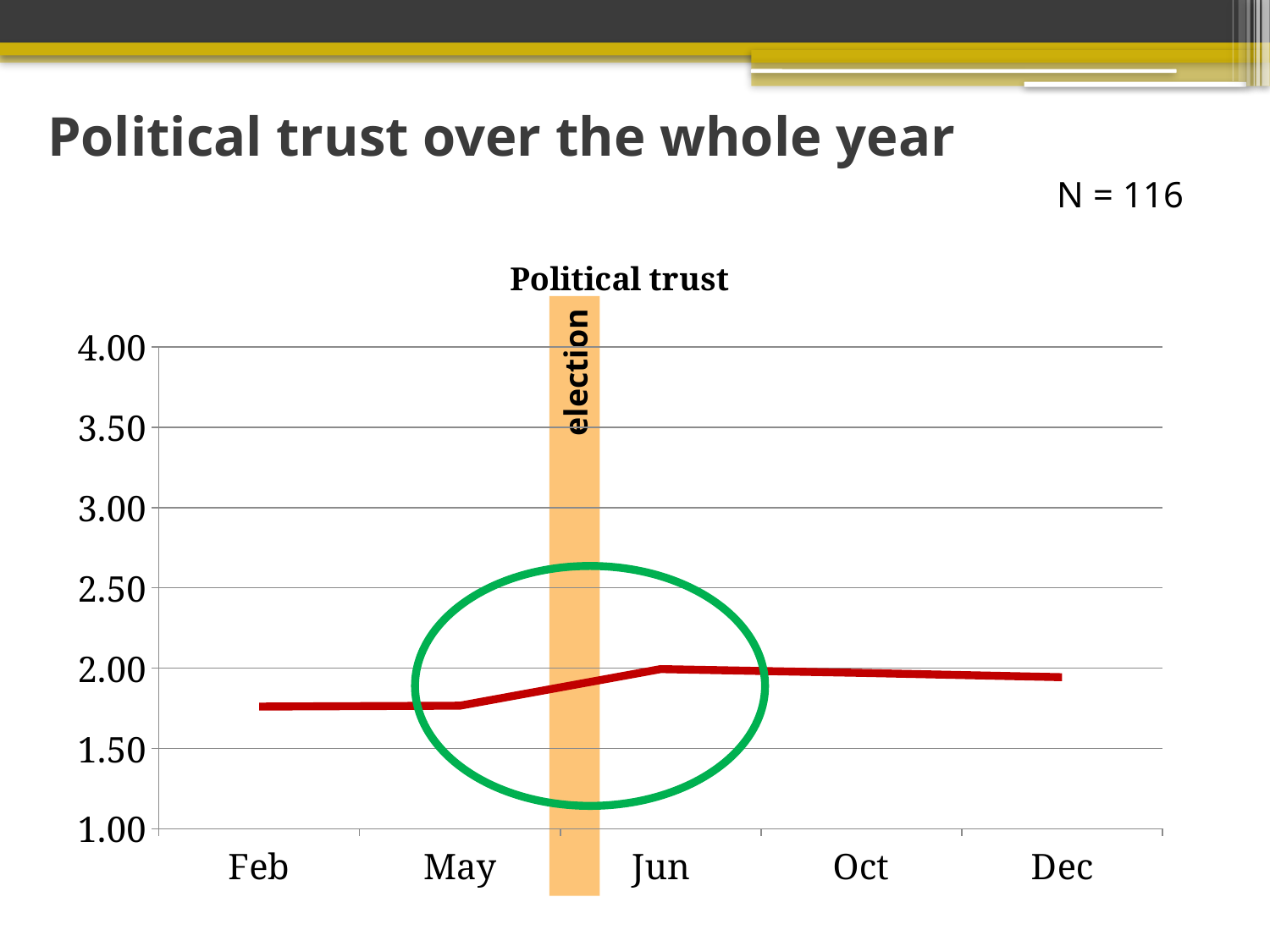
Is the value for Feb greater or less than 1.50? greater Is the value for May greater or less than 2.00? less Which is larger, the value for Jun or the value for Feb? Jun What kind of chart is shown on the slide? line chart Does political trust rise or fall between May and Jun? rise What label is written on the shaded vertical band between May and Jun? election Is the value for Dec greater or less than 1.50? greater What is the title of the chart? Political trust Which is larger, the value for Dec or the value for May? Dec How many months are plotted along the x axis of the Political trust chart? 5